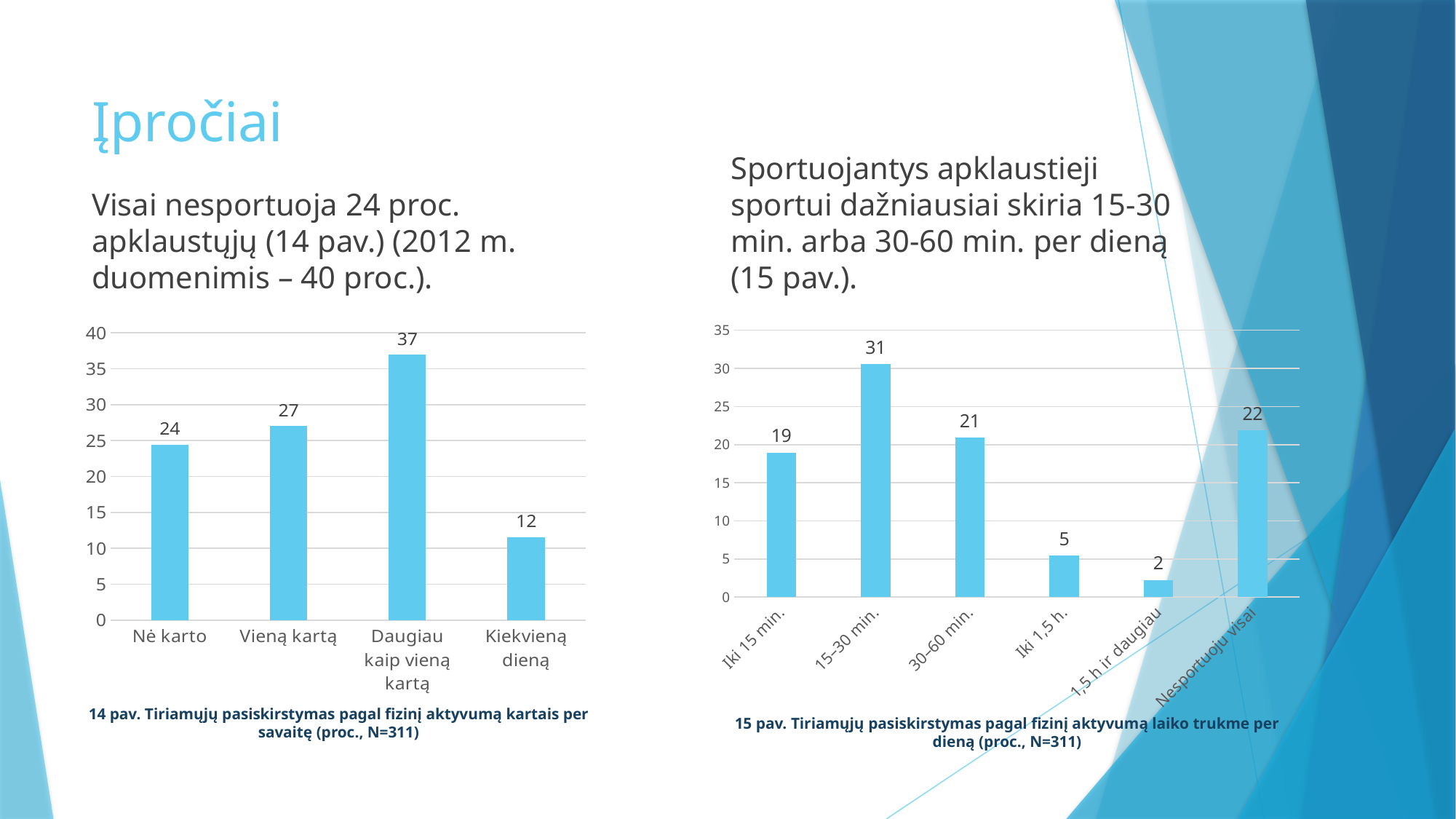
In the right chart (15 pav.), which is larger: "Iki 15 min." or "30-60 min."? 30-60 min. In the left chart (14 pav.), which category has the highest value? Daugiau kaip vieną kartą In the right chart (15 pav.), how many categories are shown? 6 In the right chart (15 pav.), which category has the lowest value? 1,5 h ir daugiau In the right chart (15 pav.), what is the value for "Nesportuoju visai"? 22 In the right chart (15 pav.), what is the value for "15-30 min."? 31 In the left chart (14 pav.), what is the difference between "Daugiau kaip vieną kartą" and "Vieną kartą"? 10 In the left chart (14 pav.), how many categories are shown? 4 In the left chart (14 pav.), what is the value for "Nė karto"? 24 In the left chart (14 pav.), which category has the lowest value? Kiekvieną dieną What kind of chart is the left chart (14 pav.)? Bar chart In the right chart (15 pav.), what is the difference between "Iki 1,5 h." and "1,5 h ir daugiau"? 3